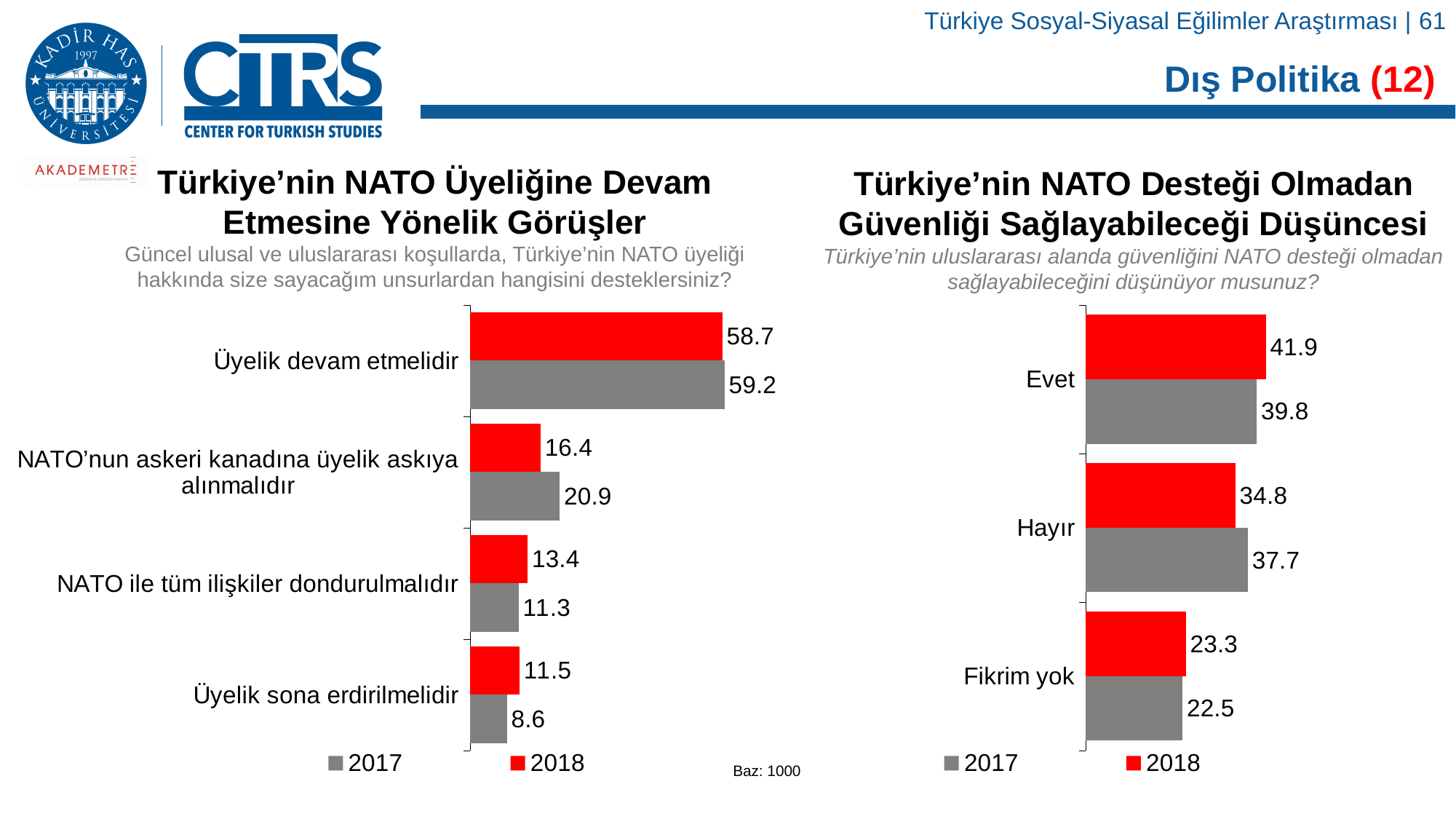
In the right chart, what is the difference between the 2018 and 2017 values for 'Evet'? 2.1 In the left chart, which category has the lowest 2017 value? Üyelik sona erdirilmelidir What type of chart is used on the left side of the slide? bar chart How many categories does the left chart show? 4 How many series does the legend of the right chart list? 2 In the right chart (Türkiye'nin NATO Desteği Olmadan Güvenliği Sağlayabileceği Düşüncesi), what is the 2018 value for 'Hayır'? 34.8 In the left chart, what is the 2017 value for 'NATO'nun askeri kanadına üyelik askıya alınmalıdır'? 20.9 In the left chart, what is the difference between the 2017 and 2018 values for 'Üyelik sona erdirilmelidir'? 2.9 In the right chart, which category has the highest 2018 value? Evet In the left chart, is the 2018 value for 'NATO ile tüm ilişkiler dondurulmalıdır' larger or smaller than its 2017 value? larger In the right chart, what is the 2017 value for 'Fikrim yok'? 22.5 In the left chart (Türkiye'nin NATO Üyeliğine Devam Etmesine Yönelik Görüşler), what is the 2018 value for 'Üyelik devam etmelidir'? 58.7